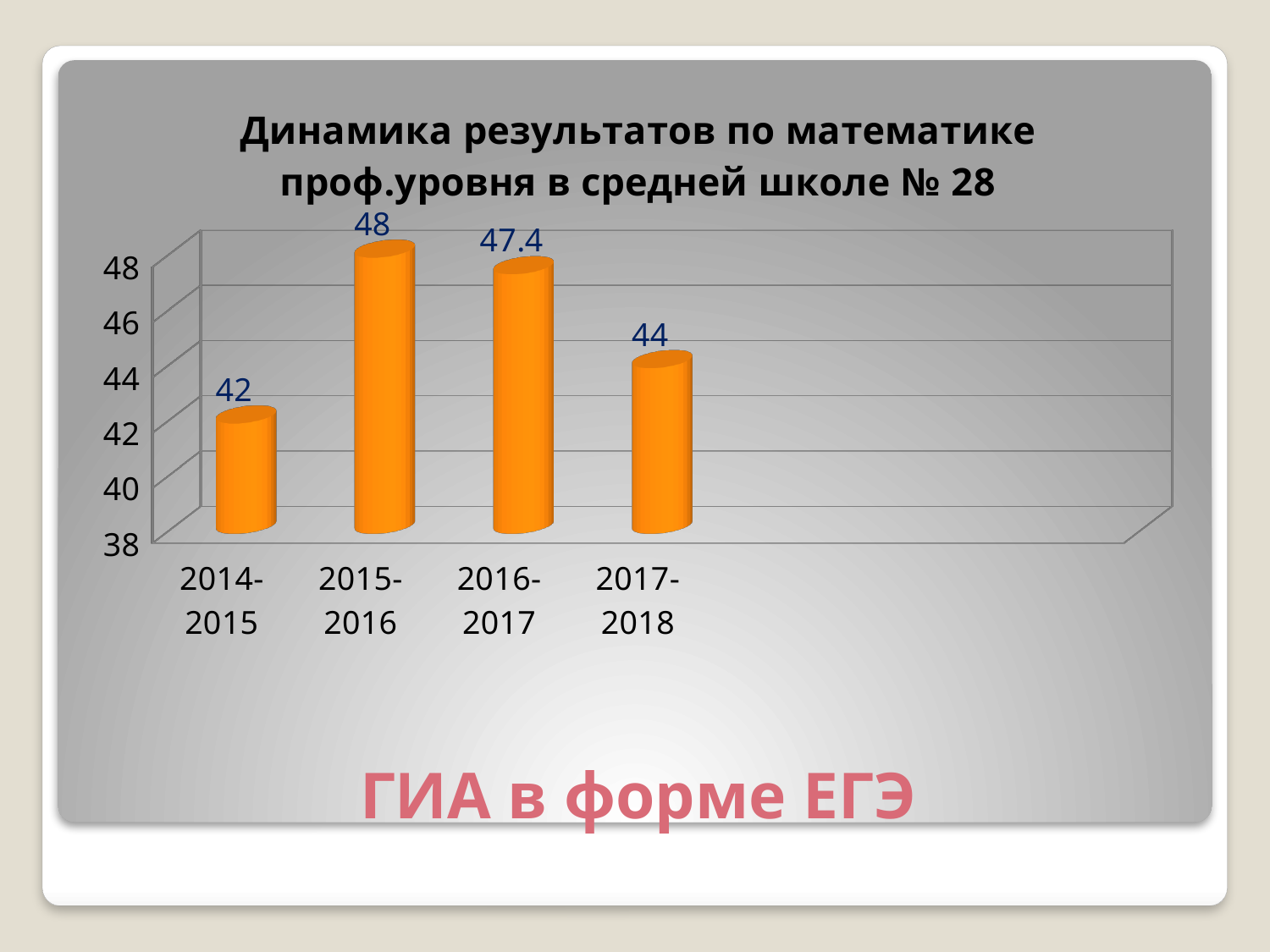
What is the value for 2015-2016? 48 What kind of chart is this? bar chart How many categories are shown on the x axis? 4 Which is larger, the value for 2017-2018 or the value for 2014-2015? 2017-2018 Which year has the highest value? 2015-2016 What is the value for 2017-2018? 44 What is the value for 2014-2015? 42 What is the difference between the values for 2015-2016 and 2014-2015? 6 What is the difference between the values for 2016-2017 and 2017-2018? 3.4 What is the title of the chart? Динамика результатов по математике проф.уровня в средней школе № 28 Which year has the lowest value? 2014-2015 What is the value for 2016-2017? 47.4